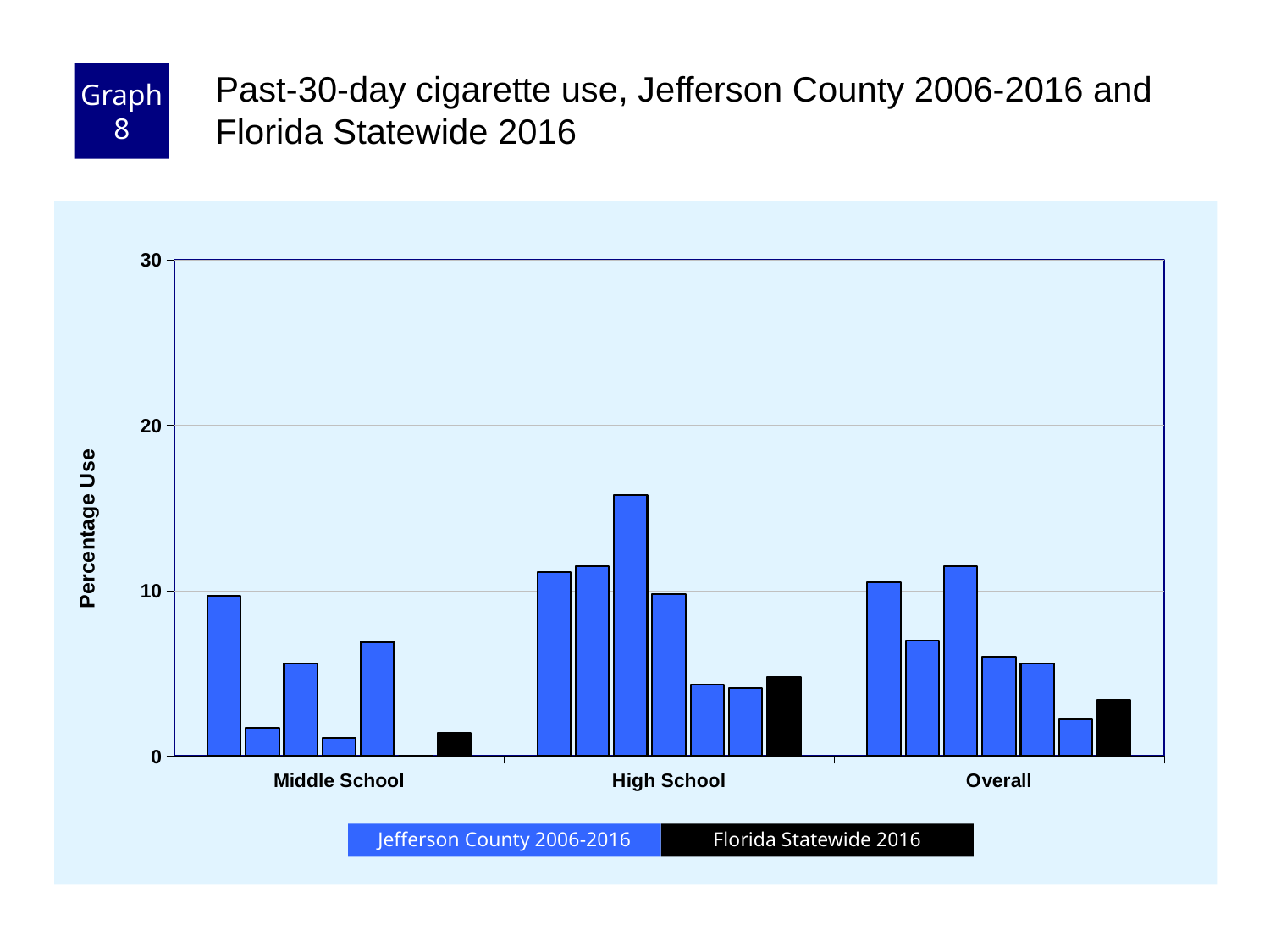
Which series is drawn in black? Florida Statewide 2016 What is the label on the y axis? Percentage Use Is the Florida Statewide 2016 value for Middle School greater or less than 10? less Which category contains the tallest bar in the chart? High School Is the tallest Jefferson County 2006-2016 bar in the High School group greater or less than 10? greater Is the Florida Statewide 2016 value larger for High School or for Middle School? High School How many series does the legend list? 2 Is the Florida Statewide 2016 value for High School greater or less than 10? less What kind of chart is shown on the slide? bar chart Which category has the lowest Florida Statewide 2016 value? Middle School How many categories are shown along the x axis? 3